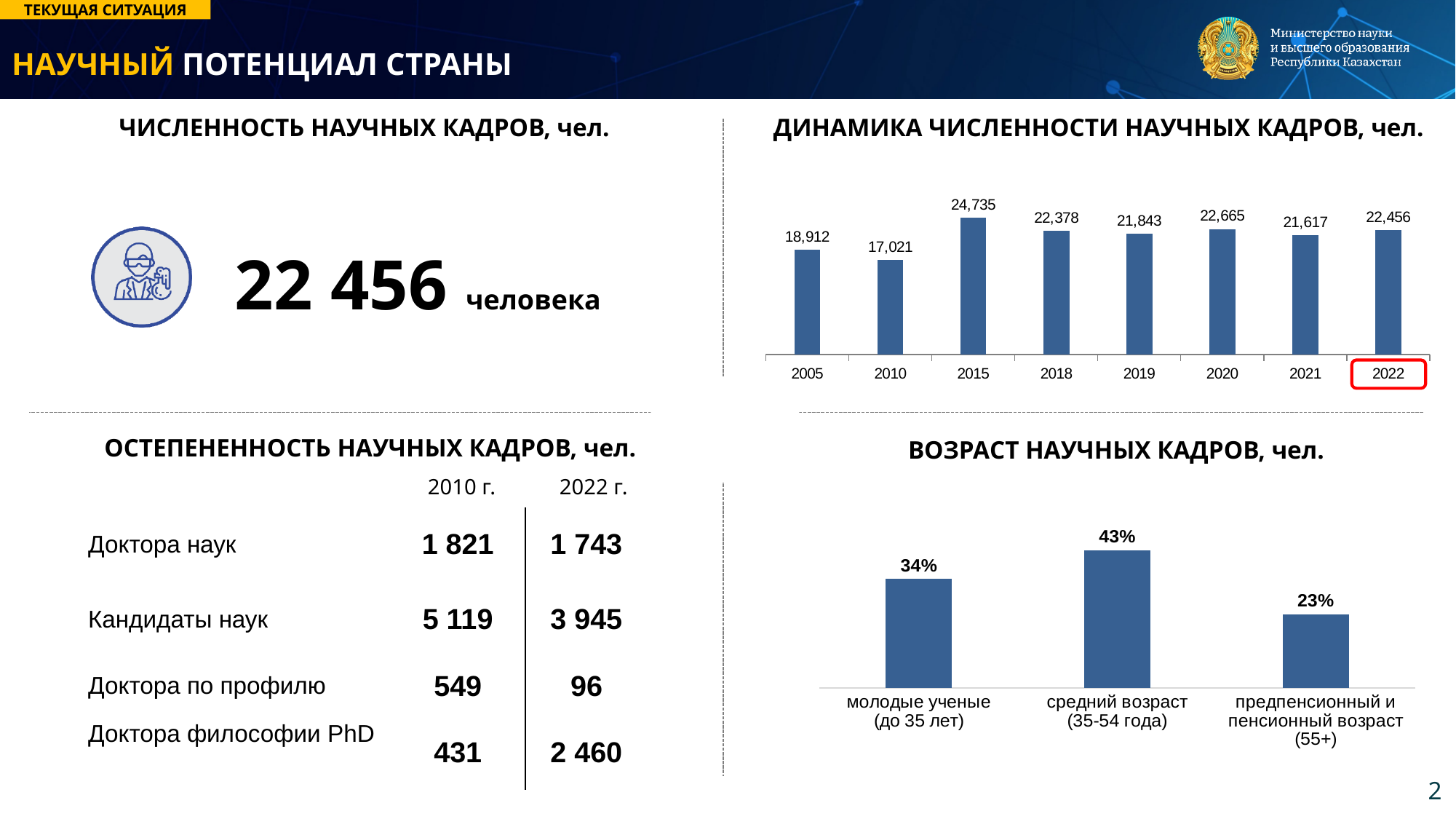
In the chart titled "ДИНАМИКА ЧИСЛЕННОСТИ НАУЧНЫХ КАДРОВ, чел.", does the value rise or fall from 2005 to 2010? Fall In the chart titled "ВОЗРАСТ НАУЧНЫХ КАДРОВ, чел.", which category has the lowest value? предпенсионный и пенсионный возраст (55+) In the chart titled "ДИНАМИКА ЧИСЛЕННОСТИ НАУЧНЫХ КАДРОВ, чел.", which is larger, the value for 2005 or the value for 2010? 2005 How many years are shown in the chart titled "ДИНАМИКА ЧИСЛЕННОСТИ НАУЧНЫХ КАДРОВ, чел."? 8 In the chart titled "ДИНАМИКА ЧИСЛЕННОСТИ НАУЧНЫХ КАДРОВ, чел.", what is the value for 2015? 24,735 What kind of chart is the one titled "ДИНАМИКА ЧИСЛЕННОСТИ НАУЧНЫХ КАДРОВ, чел."? Bar chart In the chart titled "ДИНАМИКА ЧИСЛЕННОСТИ НАУЧНЫХ КАДРОВ, чел.", what is the difference between the values for 2022 and 2021? 839 In the chart titled "ДИНАМИКА ЧИСЛЕННОСТИ НАУЧНЫХ КАДРОВ, чел.", which year has the highest value? 2015 In the chart titled "ДИНАМИКА ЧИСЛЕННОСТИ НАУЧНЫХ КАДРОВ, чел.", what is the value for 2022? 22,456 In the chart titled "ВОЗРАСТ НАУЧНЫХ КАДРОВ, чел.", what is the value for "средний возраст (35-54 года)"? 43% In the chart titled "ВОЗРАСТ НАУЧНЫХ КАДРОВ, чел.", what is the difference between the values for "средний возраст (35-54 года)" and "молодые ученые (до 35 лет)"? 9% In the chart titled "ДИНАМИКА ЧИСЛЕННОСТИ НАУЧНЫХ КАДРОВ, чел.", which year has the lowest value? 2010